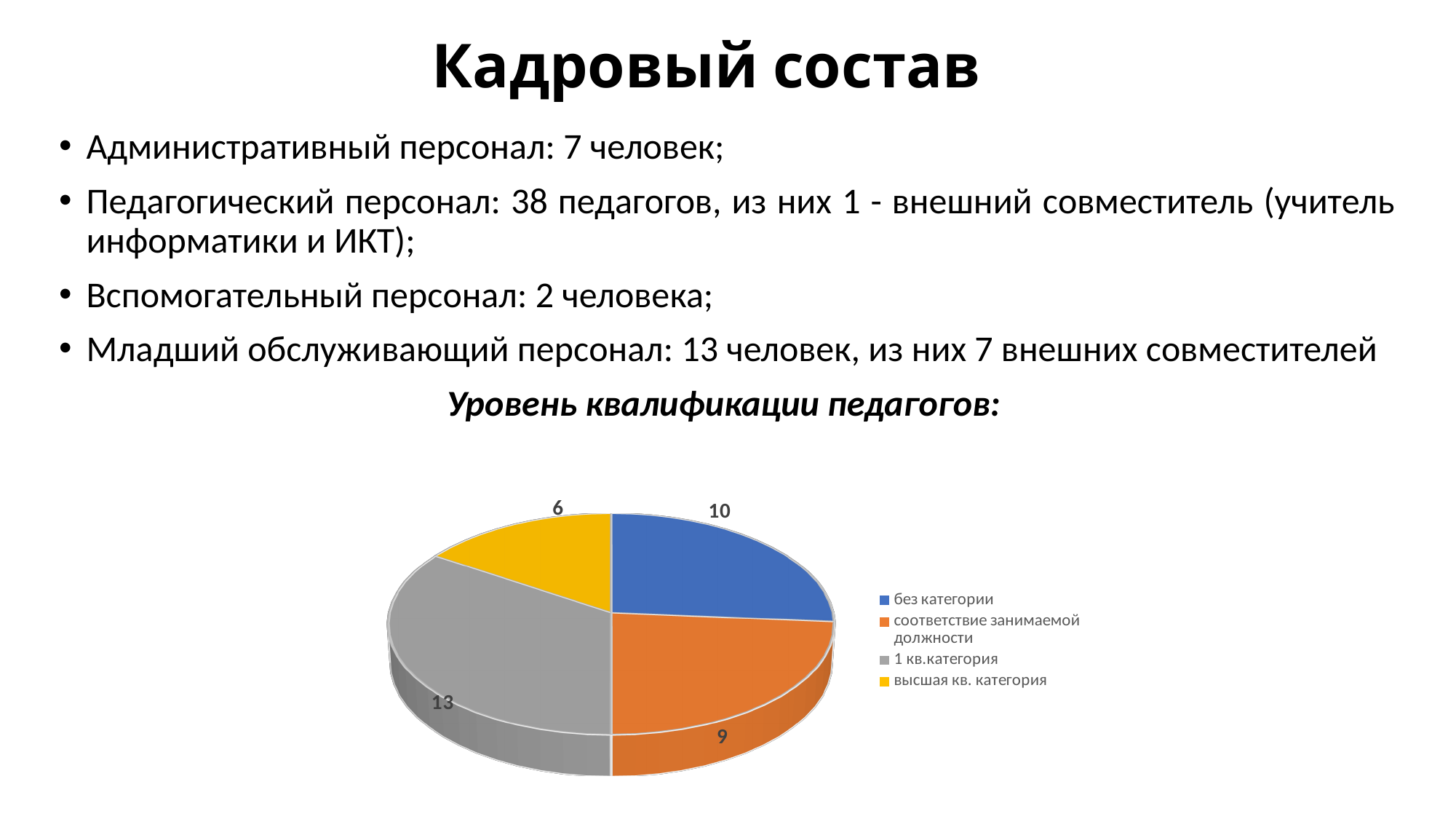
What type of chart is shown on the slide? pie chart Which is larger: the value for "без категории" or for "соответствие занимаемой должности"? без категории What is the value for "без категории" in the pie chart? 10 What is the difference between the values for "1 кв.категория" and "высшая кв. категория"? 7 What colour is the slice for "высшая кв. категория" in the pie chart? yellow Which category has the largest slice in the pie chart? 1 кв.категория Which category has the smallest slice in the pie chart? высшая кв. категория What is the value for "высшая кв. категория" in the pie chart? 6 What is the value for "соответствие занимаемой должности" in the pie chart? 9 What is the total of all slices in the pie chart? 38 How many slices does the pie chart have? 4 What is the value for "1 кв.категория" in the pie chart? 13